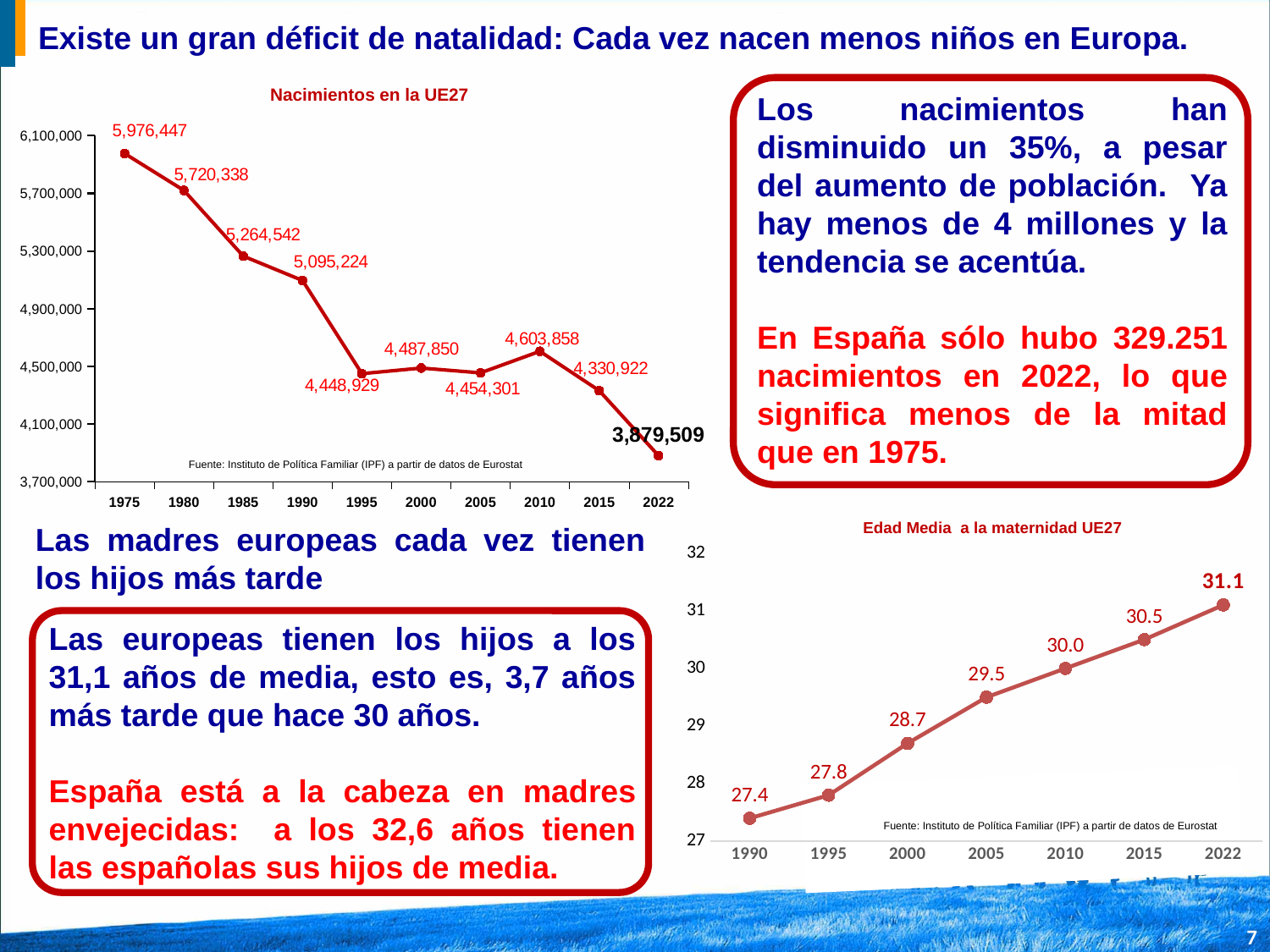
How many data points are plotted in the 'Nacimientos en la UE27' chart? 10 In the 'Edad Media a la maternidad UE27' chart, what is the difference between the 2022 and 1990 values? 3.7 In the 'Nacimientos en la UE27' chart, which year has the lowest value? 2022 How many data points are plotted in the 'Edad Media a la maternidad UE27' chart? 7 In the 'Nacimientos en la UE27' chart, what is the value for 2022? 3,879,509 In the 'Edad Media a la maternidad UE27' chart, what is the value for 2005? 29.5 In the 'Nacimientos en la UE27' chart, what is the difference between the 1975 and 2022 values? 2,096,938 What type of chart is 'Nacimientos en la UE27'? line chart In the 'Nacimientos en la UE27' chart, which is larger, the value for 2000 or the value for 2010? 2010 In the 'Nacimientos en la UE27' chart, what is the value for 1975? 5,976,447 In the 'Edad Media a la maternidad UE27' chart, which year has the highest value? 2022 In the 'Edad Media a la maternidad UE27' chart, do the values rise or fall from 1990 to 2022? rise